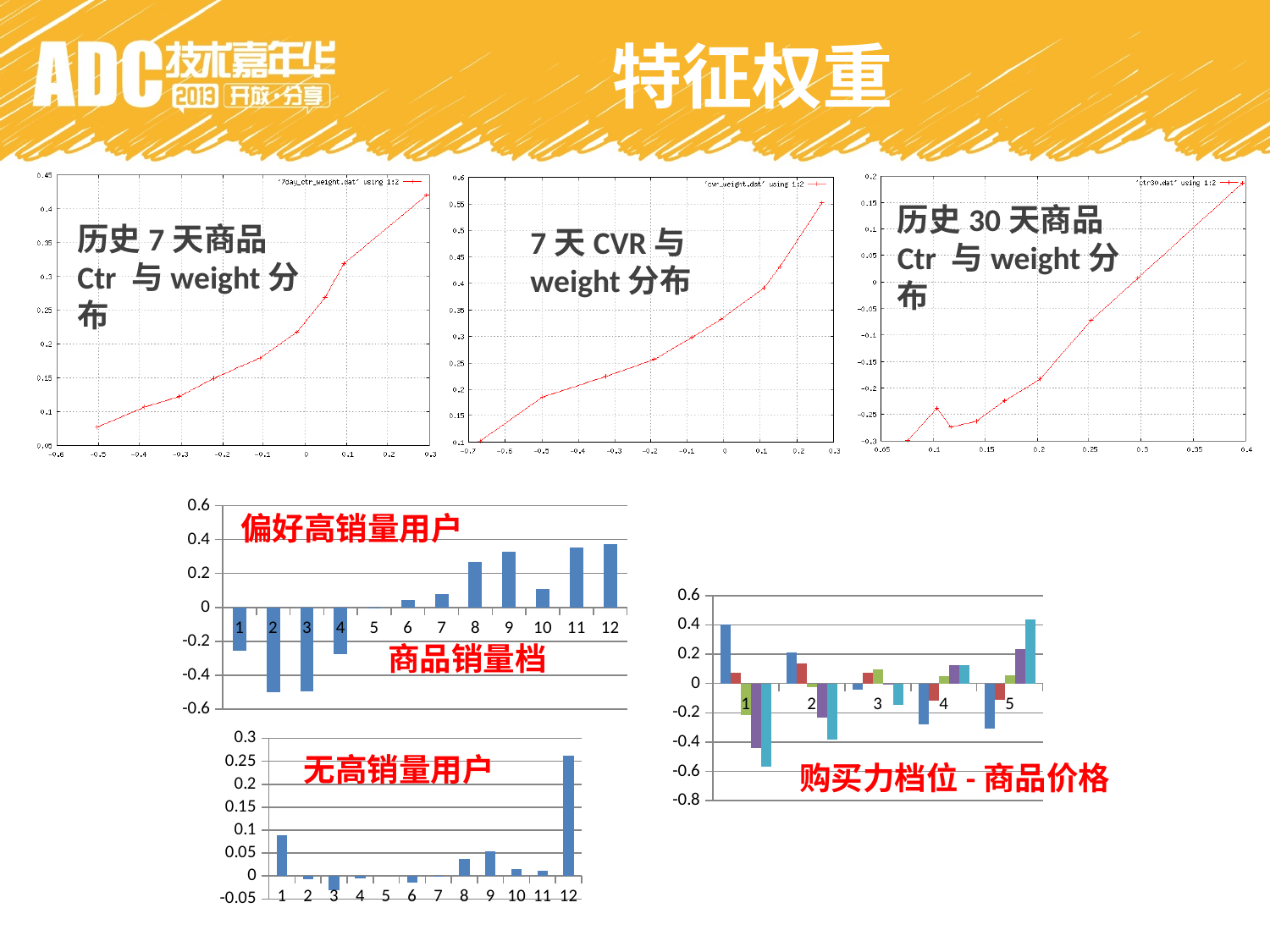
In the chart titled 偏好高销量用户, do the values generally rise or fall from category 1 to category 12? rise In the chart titled 偏好高销量用户, is the value for category 2 greater or less than -0.4? less In the chart titled 偏好高销量用户, is the value for category 12 greater or less than 0.2? greater How many categories are shown on the x axis of the chart titled 购买力档位 - 商品价格? 5 What kind of chart is the top-left chart titled 历史 7 天商品 Ctr 与 weight 分布? line chart What kind of chart is the chart titled 偏好高销量用户? bar chart In the chart titled 无高销量用户, is the value for category 1 greater or less than 0.05? greater In the chart titled 无高销量用户, which category has the highest value? 12 In the top-middle chart titled 7 天 CVR 与 weight 分布, does the line rise or fall along the x axis? rise How many categories are shown on the x axis of the chart titled 偏好高销量用户? 12